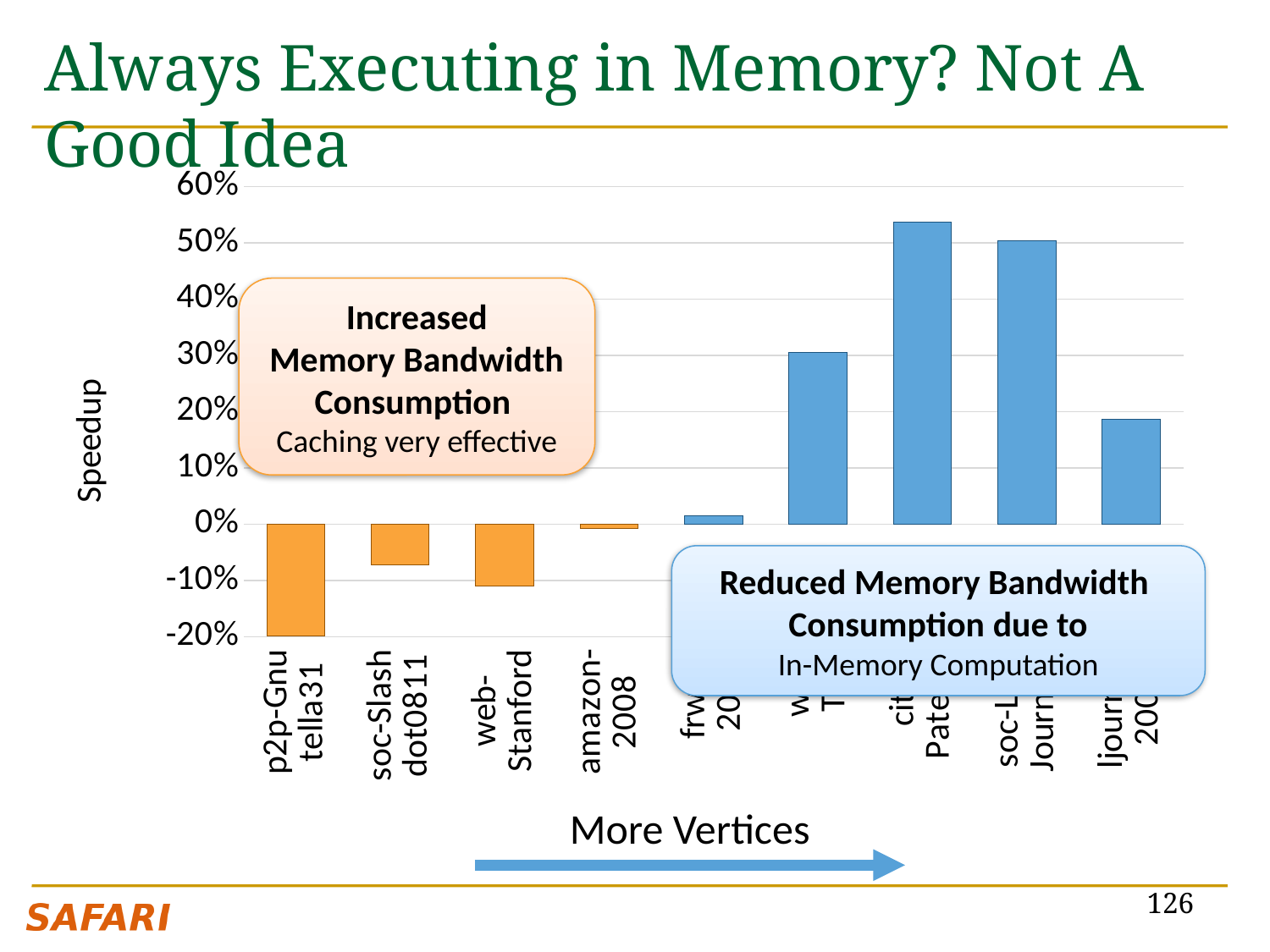
What colour are the bars with negative speedup values? orange How many bars (categories) does the chart show? 9 What is the label of the vertical axis of the chart? Speedup What kind of chart is shown on the slide? bar chart Is the speedup for web-Stanford greater or less than -20%? greater How many bars in the chart have a negative speedup? 4 Which has the lower speedup, web-Stanford or soc-Slashdot0811? web-Stanford Is the speedup for soc-Slashdot0811 greater or less than -10%? greater Do the speedup values generally rise or fall moving left to right along the x axis? rise Is the speedup for p2p-Gnutella31 greater or less than -10%? less Which category has the lowest speedup in the chart? p2p-Gnutella31